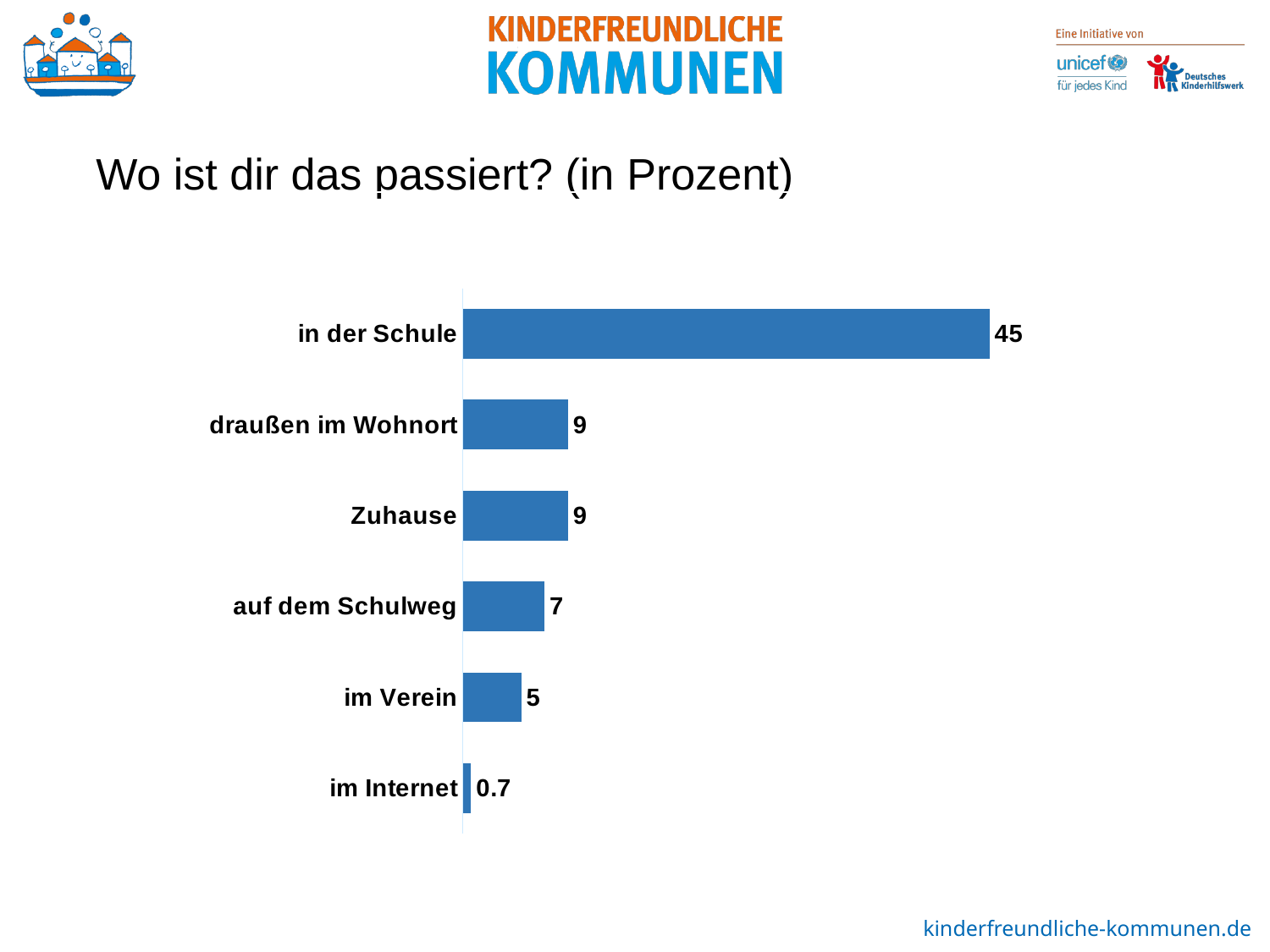
What is the value for "im Internet"? 0.7 Which category has the highest value? in der Schule What is the value for "im Verein"? 5 What is the value for "in der Schule"? 45 Which category has the lowest value? im Internet What is the difference between the values for "auf dem Schulweg" and "im Verein"? 2 Which is larger, the value for "Zuhause" or the value for "im Verein"? Zuhause What is the title of the slide above the chart? Wo ist dir das passiert? (in Prozent) What is the difference between the values for "in der Schule" and "draußen im Wohnort"? 36 How many categories are shown in the chart? 6 What is the value for "auf dem Schulweg"? 7 What kind of chart is shown on the slide? bar chart